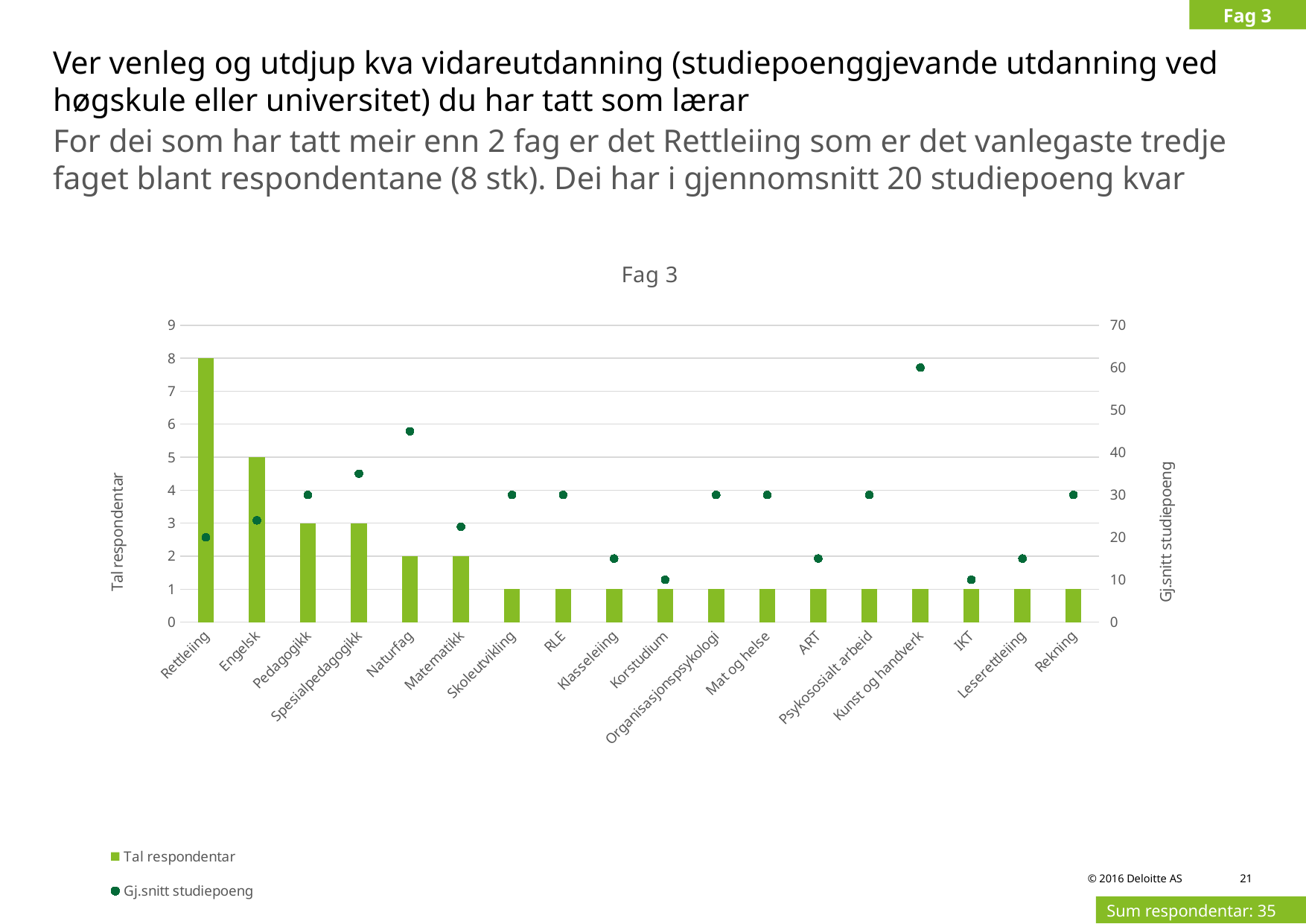
What is the number of respondents (Tal respondentar) for Rettleiing? 8 What kind of chart is shown on the slide? bar chart with points (combination chart) What is the difference in number of respondents between Rettleiing and Engelsk? 3 Which category has the highest average study points (Gj.snitt studiepoeng)? Kunst og handverk What is the number of respondents (Tal respondentar) for Engelsk? 5 Which category has the highest number of respondents? Rettleiing What is the average study points (Gj.snitt studiepoeng) for Kunst og handverk? 60 What is the title of the chart? Fag 3 Is the average study points (Gj.snitt studiepoeng) for Naturfag greater or less than 40? greater How many series does the legend list? 2 How many categories are shown on the x axis? 18 Which has more respondents, Pedagogikk or Naturfag? Pedagogikk